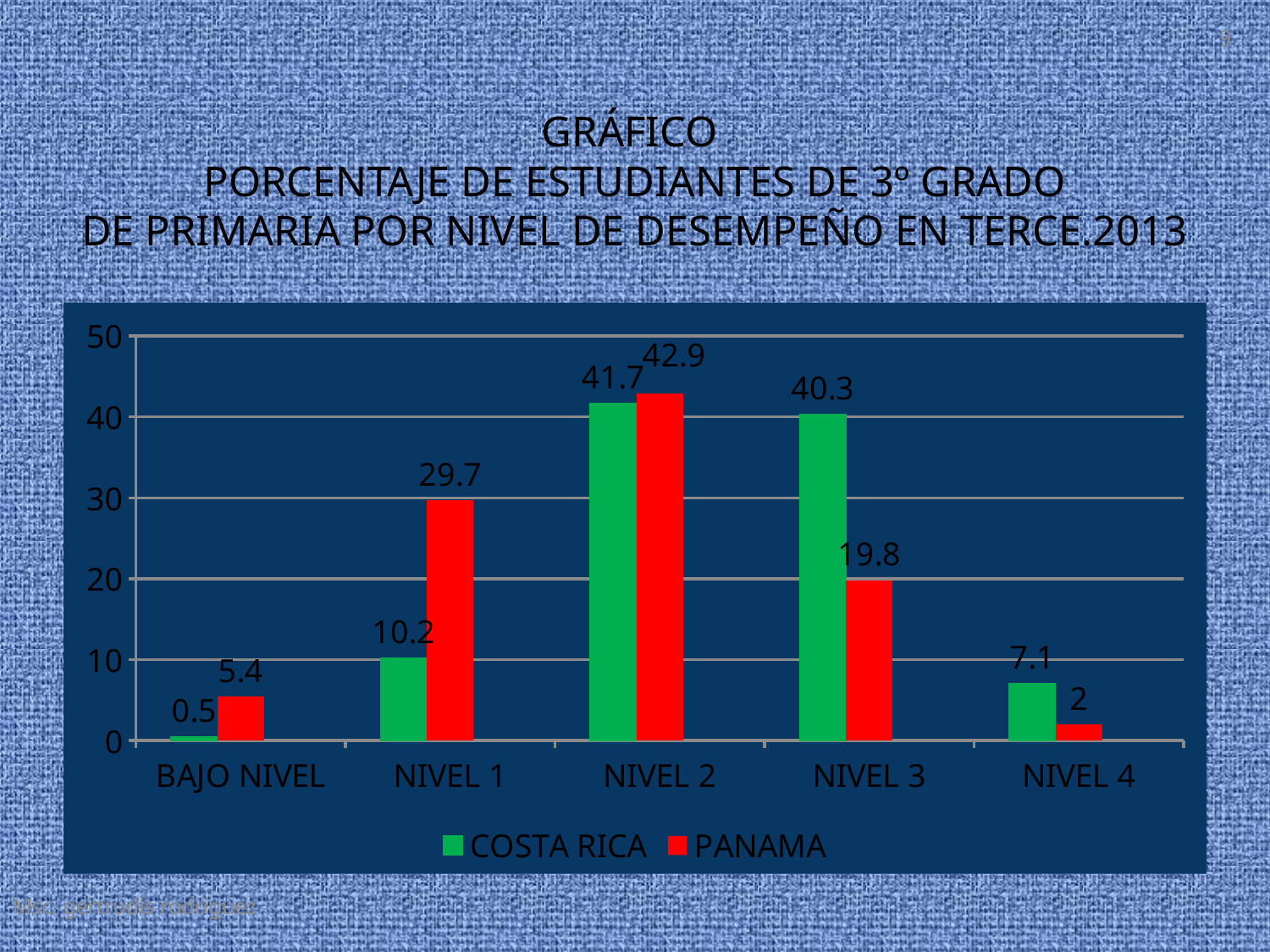
Which is larger at NIVEL 1, the value for COSTA RICA or for PANAMA? PANAMA Is the value for COSTA RICA at NIVEL 3 greater or less than 30? greater Which category has the highest value for PANAMA? NIVEL 2 Which colour represents PANAMA in the chart? red What is the value for PANAMA at NIVEL 1? 29.7 What is the value for COSTA RICA at NIVEL 2? 41.7 What is the value for PANAMA at NIVEL 4? 2 Which category has the lowest value for COSTA RICA? BAJO NIVEL What is the difference between the PANAMA and COSTA RICA values at NIVEL 3? 20.5 How many categories are shown on the x axis? 5 What kind of chart is shown on the slide? bar chart How many series does the legend list? 2